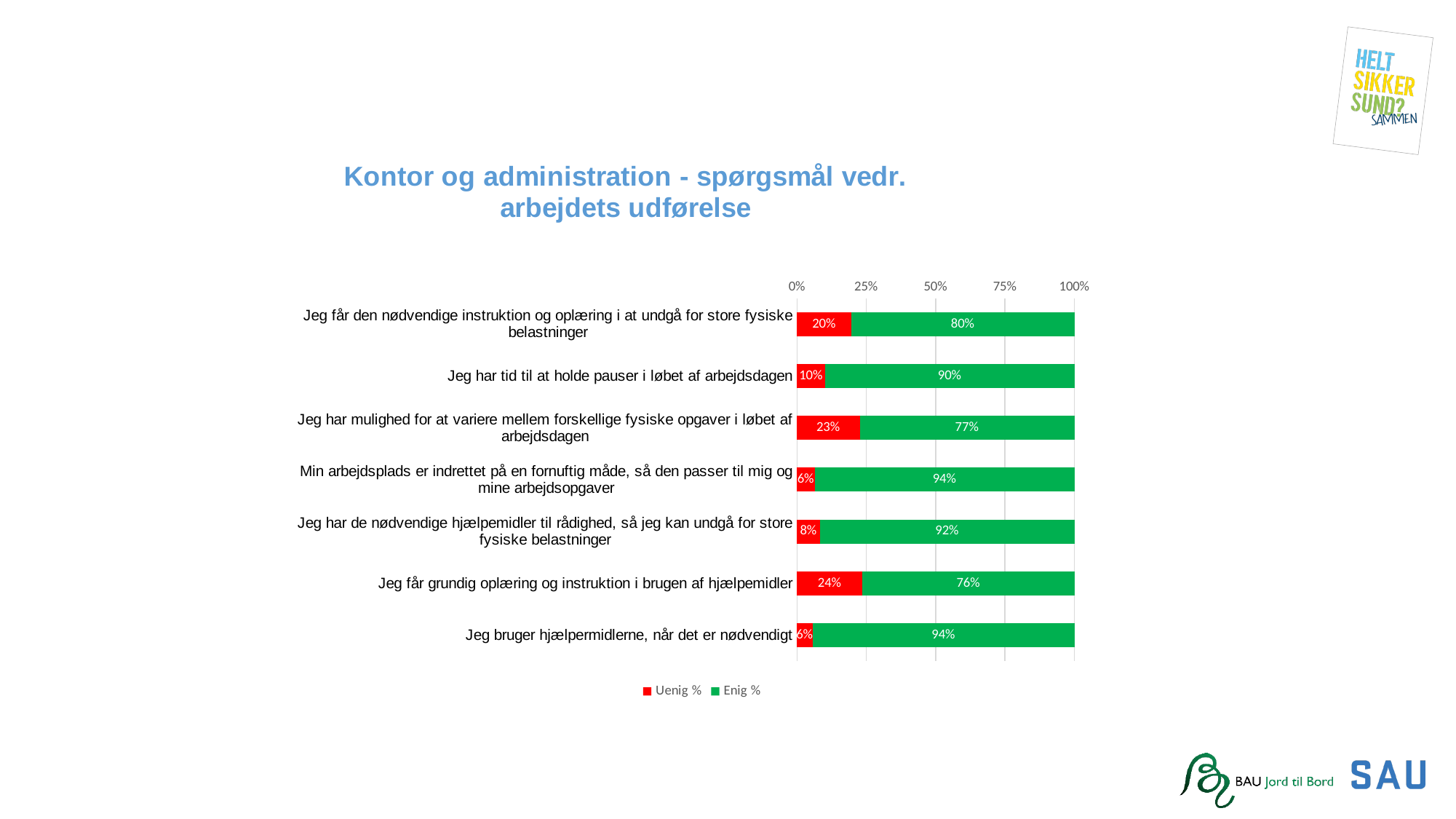
What is the difference between the Enig % values for "Jeg har tid til at holde pauser i løbet af arbejdsdagen" and "Jeg får den nødvendige instruktion og oplæring i at undgå for store fysiske belastninger"? 10% Which statement has the lowest Enig % value? Jeg får grundig oplæring og instruktion i brugen af hjælpemidler Which has a larger Uenig % value: "Jeg får den nødvendige instruktion og oplæring i at undgå for store fysiske belastninger" or "Jeg har tid til at holde pauser i løbet af arbejdsdagen"? Jeg får den nødvendige instruktion og oplæring i at undgå for store fysiske belastninger What kind of chart is shown on the slide? Stacked bar chart What is the Uenig % value for "Jeg får grundig oplæring og instruktion i brugen af hjælpemidler"? 24% What is the Uenig % value for "Jeg har mulighed for at variere mellem forskellige fysiske opgaver i løbet af arbejdsdagen"? 23% What is the total of the stacked bar for "Min arbejdsplads er indrettet på en fornuftig måde, så den passer til mig og mine arbejdsopgaver"? 100% What is the Enig % value for "Jeg har de nødvendige hjælpemidler til rådighed, så jeg kan undgå for store fysiske belastninger"? 92% What is the Enig % value for "Jeg har tid til at holde pauser i løbet af arbejdsdagen"? 90% How many statements (categories) are shown in the chart? 7 Which statement has the highest Uenig % value? Jeg får grundig oplæring og instruktion i brugen af hjælpemidler How many series does the legend list? 2